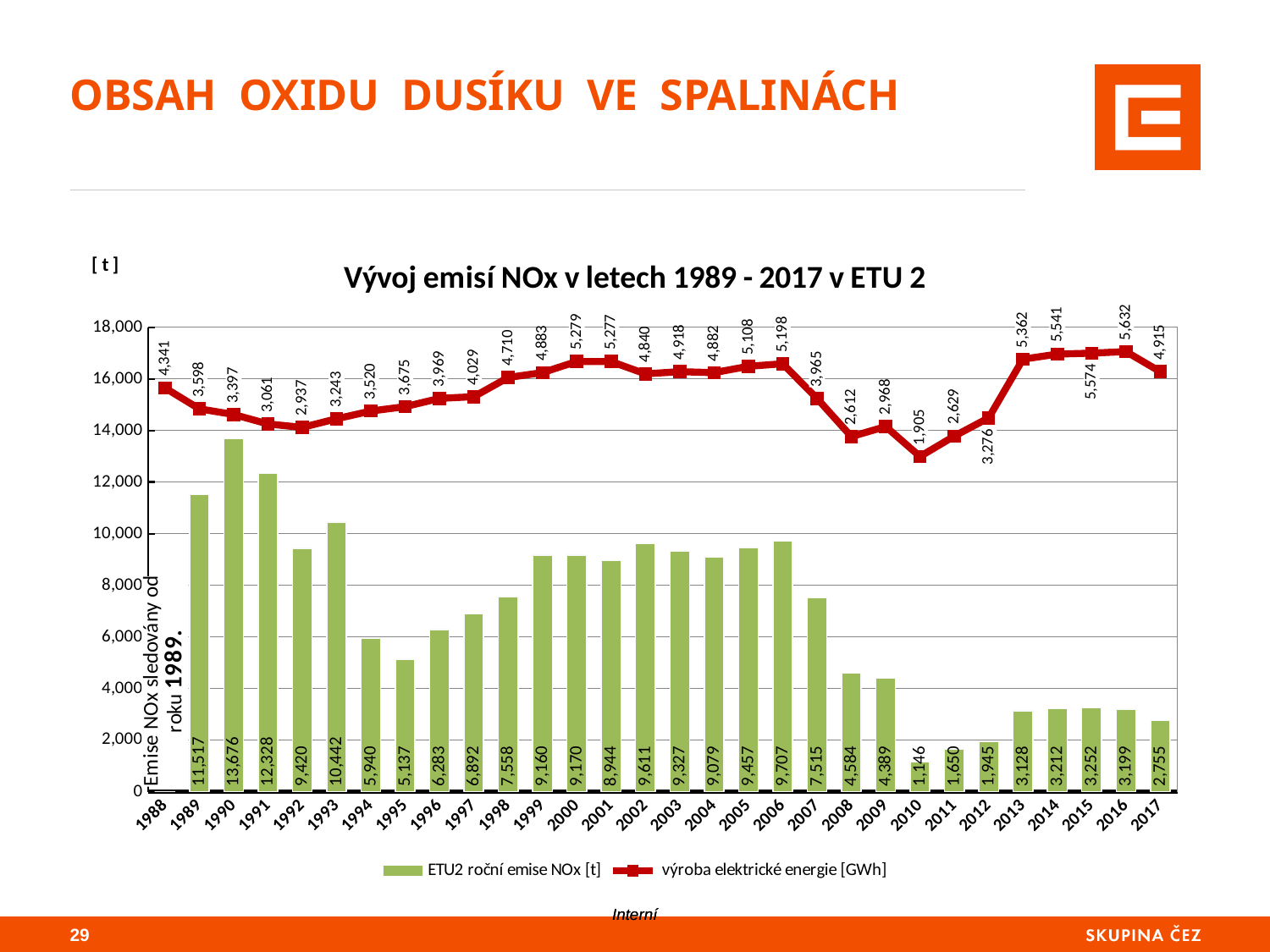
What is the difference between the ETU2 NOx emissions in 1989 and in 2017? 8,762 Which year has the lowest ETU2 annual NOx emissions? 2010 Which year has the lowest electricity production value on the line? 2010 What kind of chart is used for the ETU2 annual NOx emissions series? Bar chart Which year has the highest ETU2 annual NOx emissions? 1990 How many series does the legend list? 2 What was the electricity production (výroba elektrické energie) in 2016? 5,632 What were the ETU2 annual NOx emissions in 1990? 13,676 Which year had higher ETU2 NOx emissions, 2006 or 2007? 2006 What is the title of the chart? Vývoj emisí NOx v letech 1989 - 2017 v ETU 2 How many years are shown on the x axis? 30 Is the ETU2 NOx emissions value for 1993 greater or less than 10,000? greater